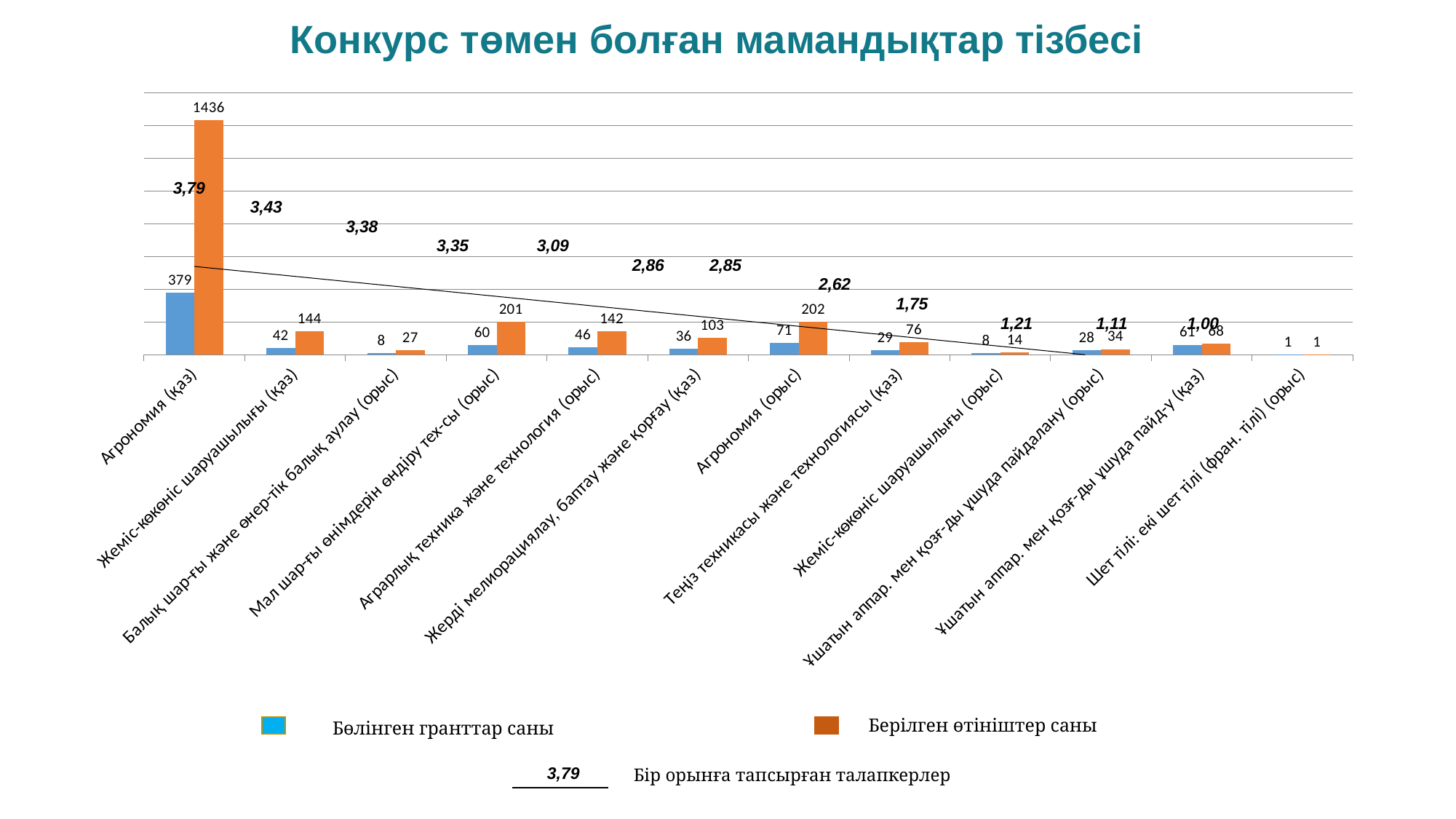
What is the value of Берілген өтініштер саны for Агрономия (қаз)? 1436 What is the value of Бөлінген гранттар саны for Агрономия (орыс)? 71 How many series does the legend list? 3 What is the difference between Берілген өтініштер саны and Бөлінген гранттар саны for Аграрлық техника және технология (орыс)? 96 How many categories are shown on the x axis? 12 Which is larger: Бөлінген гранттар саны for Ұшатын аппар. мен қозғ-ды ұшуда пайд-у (қаз) or for Теңіз техникасы және технологиясы (қаз)? Ұшатын аппар. мен қозғ-ды ұшуда пайд-у (қаз) What kind of chart is this? Bar chart with a line What is the title of the chart? Конкурс төмен болған мамандықтар тізбесі Which category has the highest value of Берілген өтініштер саны? Агрономия (қаз) Which category has the lowest value of Бөлінген гранттар саны? Шет тілі: екі шет тілі (фран. тілі) (орыс) What is the value of Берілген өтініштер саны for Мал шар-ғы өнімдерін өндіру тех-сы (орыс)? 201 Does the Бір орынға тапсырған талапкерлер line rise or fall from left to right? Fall